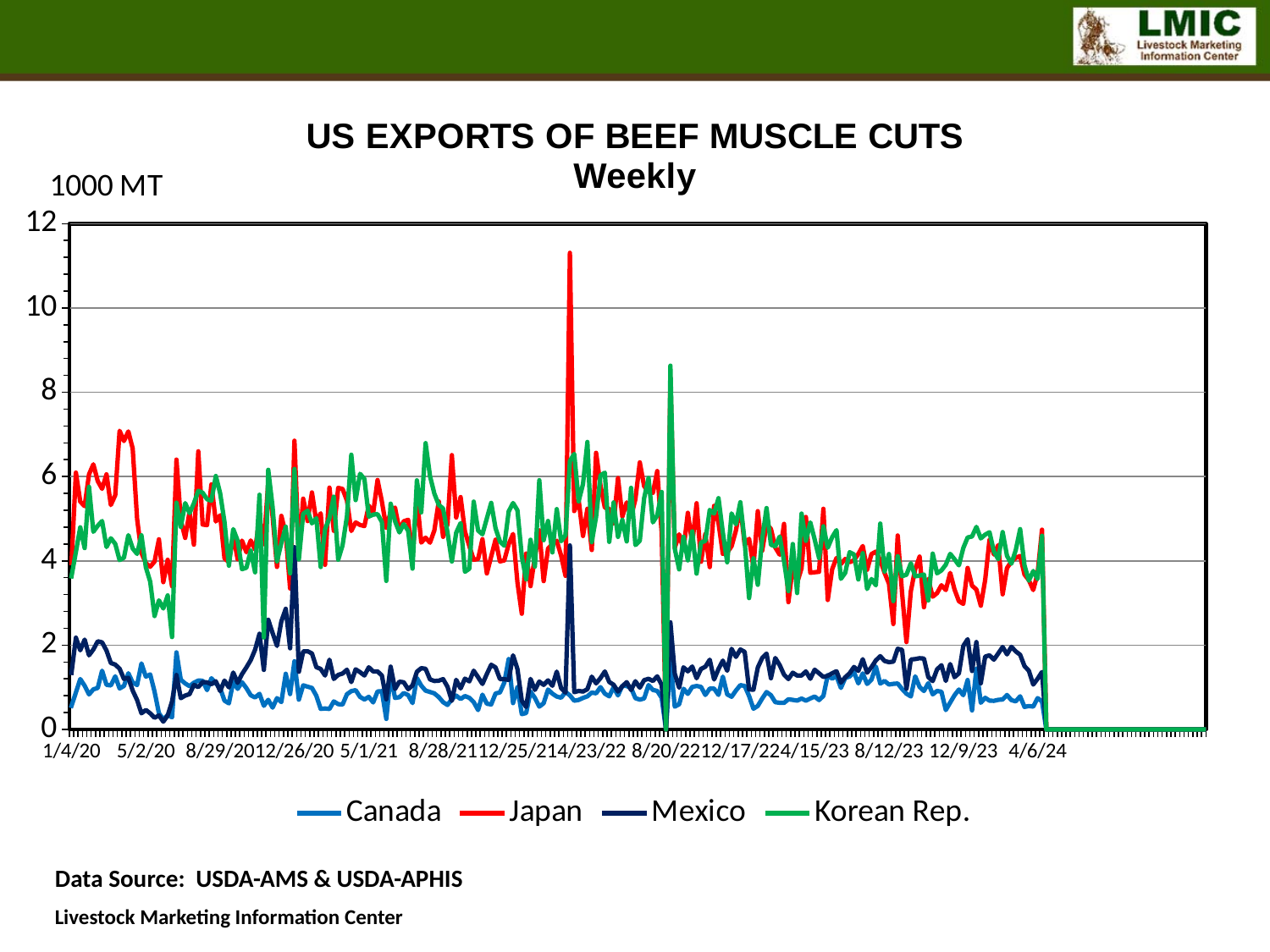
Is the highest peak of the Japan series greater or less than 10? greater What kind of chart is shown on the slide? Line chart Which series reaches the highest peak on the chart? Japan What is the title of the chart? US EXPORTS OF BEEF MUSCLE CUTS Weekly Which series is higher for most of the chart, Japan or Mexico? Japan Is the value for Canada at the start of the chart (1/4/20) greater or less than 2? less Which series stays lowest across most of the chart? Canada Does the Japan series generally rise or fall from 2020 to 2024? fall What unit is shown on the y axis of the chart? 1000 MT Is the highest peak of the Korean Rep. series greater or less than 8? greater What is the maximum value shown on the y axis? 12 How many series does the legend list? 4